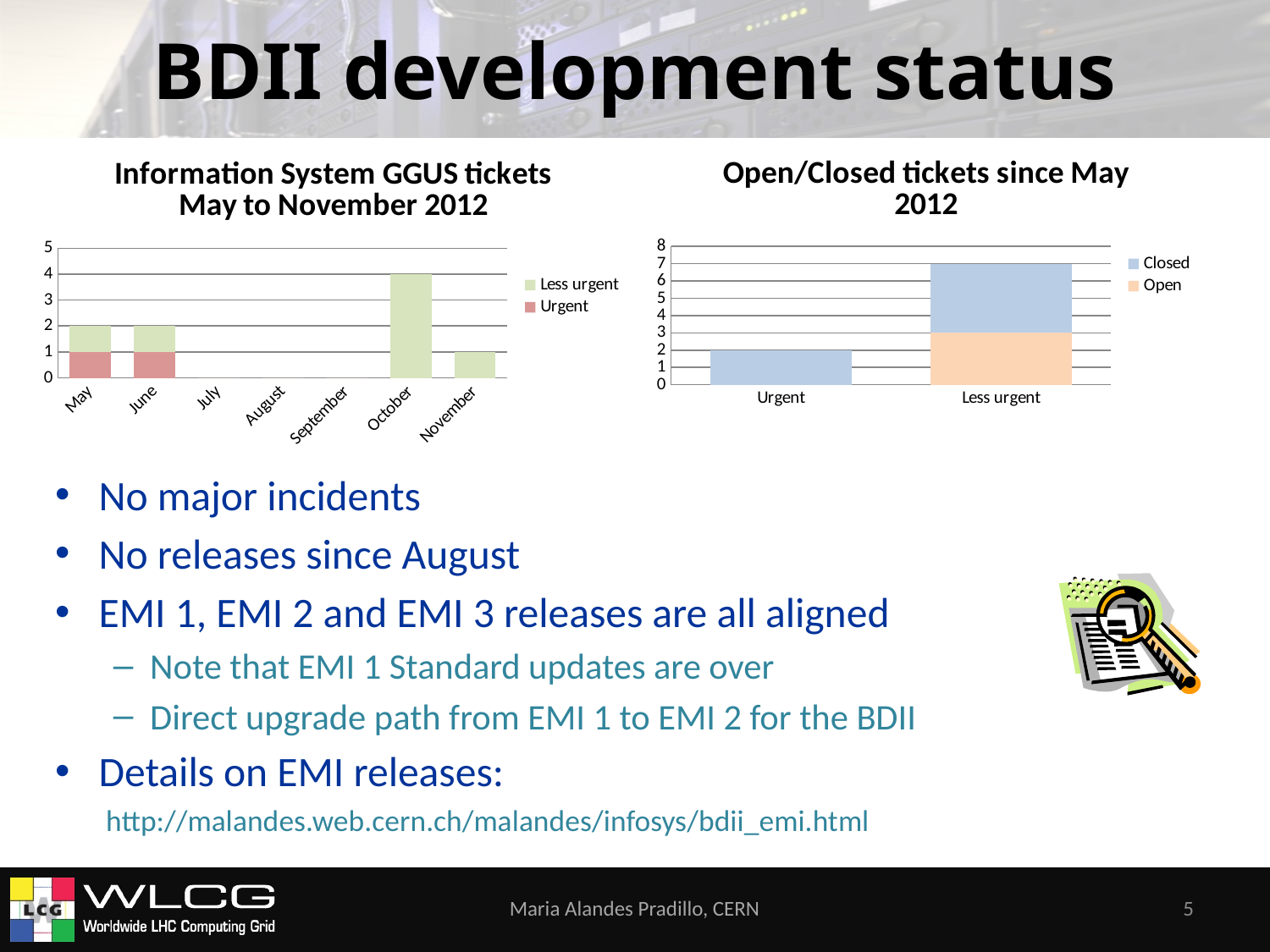
In the 'Information System GGUS tickets May to November 2012' chart, what is the total number of tickets in May? 2 In the 'Open/Closed tickets since May 2012' chart, what is the number of Closed Urgent tickets? 2 In the 'Information System GGUS tickets May to November 2012' chart, how many months are shown on the x axis? 7 In the 'Information System GGUS tickets May to November 2012' chart, what is the total number of tickets in October? 4 In the 'Open/Closed tickets since May 2012' chart, which category has the larger total, Urgent or Less urgent? Less urgent In the 'Information System GGUS tickets May to November 2012' chart, which month has the highest total number of tickets? October In the 'Information System GGUS tickets May to November 2012' chart, is the total for October greater or less than 3? greater In the 'Information System GGUS tickets May to November 2012' chart, which months have Urgent tickets? May and June In the 'Information System GGUS tickets May to November 2012' chart, how many series does the legend list? 2 In the 'Open/Closed tickets since May 2012' chart, what is the total number of Less urgent tickets? 7 In the 'Information System GGUS tickets May to November 2012' chart, what type of chart is shown? stacked bar chart In the 'Open/Closed tickets since May 2012' chart, how many series does the legend list? 2